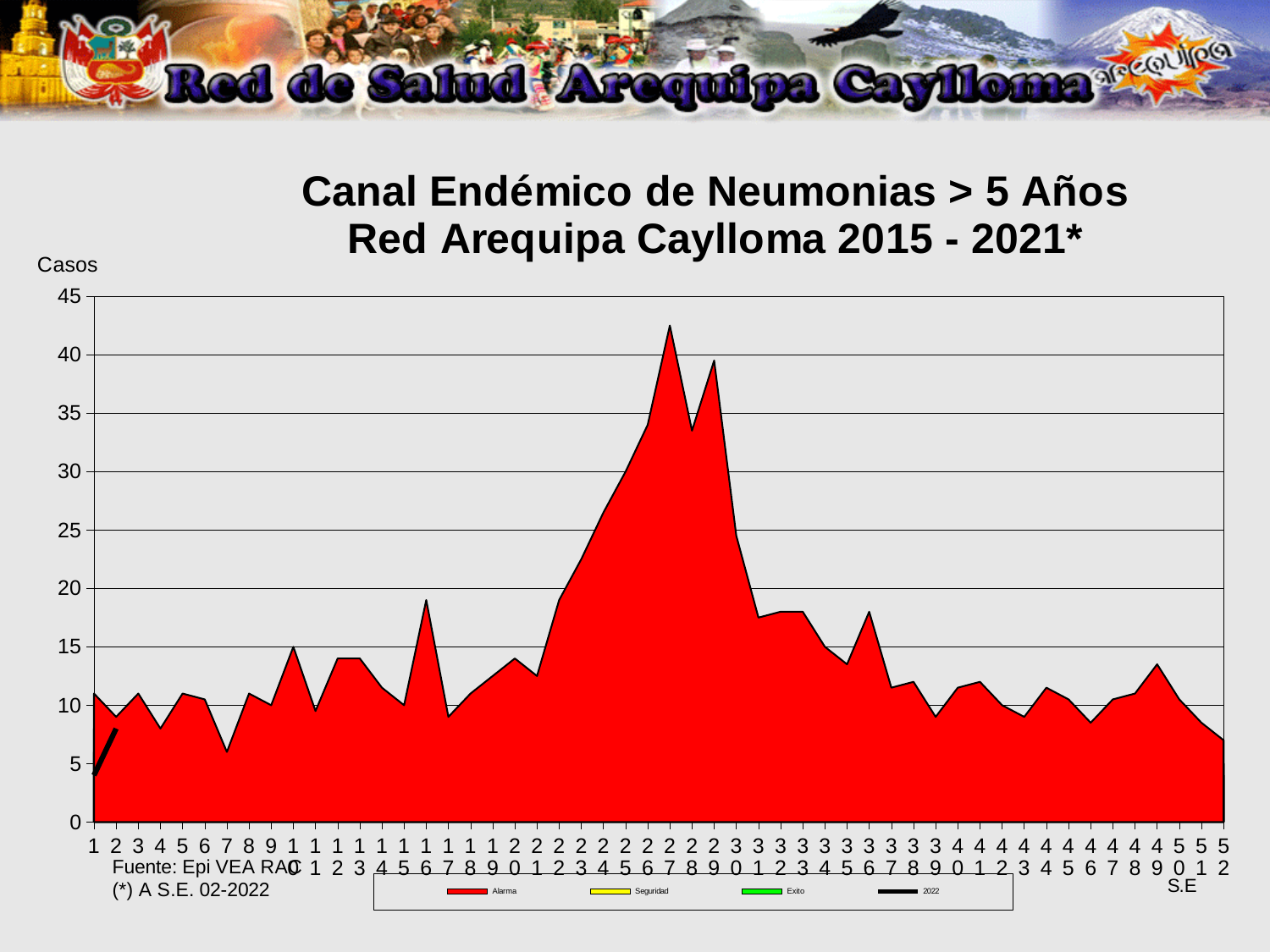
Is the Alarma value at week 27 greater or less than 40? greater Do the Alarma values rise or fall from week 20 to week 27? rise Is the Alarma value at week 31 greater or less than 20? less Which epidemiological week (S.E.) has the highest Alarma value? 27 Is the Alarma value at week 7 greater or less than 10? less How many epidemiological weeks are shown on the x axis? 52 What kind of chart is shown on the slide? area chart What colour is the Alarma series in the legend? red How many series does the legend list? 4